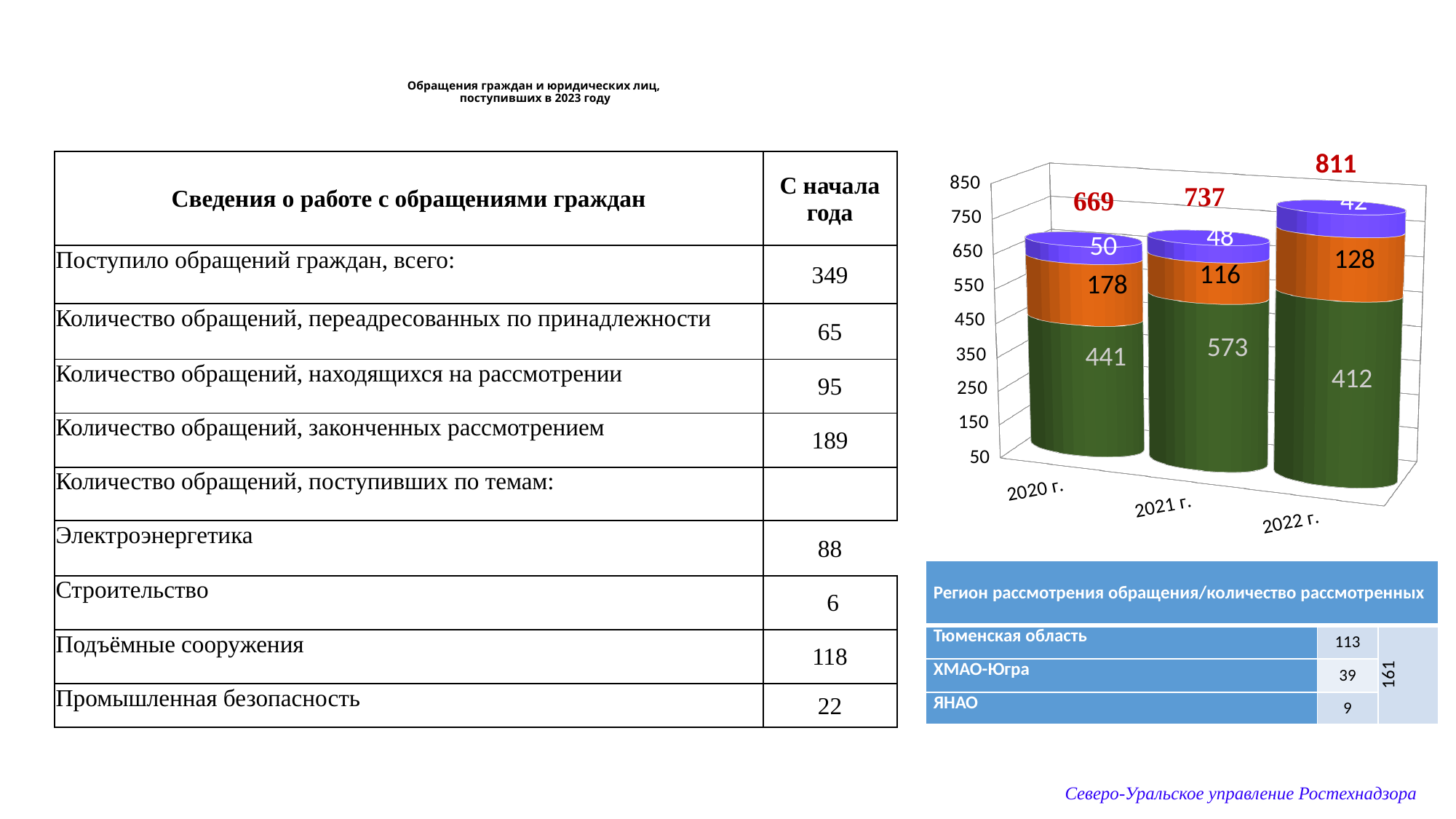
How many years (categories) are shown on the x axis of the chart? 3 What is the value of the green (bottom) segment for 2020 г.? 441 What is the value of the purple (top) segment for 2020 г.? 50 What is the total shown above the stacked bar for 2020 г.? 669 What is the value of the orange (middle) segment for 2021 г.? 116 What is the total shown above the stacked bar for 2021 г.? 737 What is the difference between the orange segment values for 2020 г. and 2021 г.? 62 Which year has the highest total in the chart? 2022 г. Which year has the larger green (bottom) segment, 2020 г. or 2021 г.? 2021 г. What kind of chart is shown on the right side of the slide? bar chart Do the totals above the bars rise or fall from 2020 г. to 2022 г.? rise What is the value of the orange (middle) segment for 2022 г.? 128